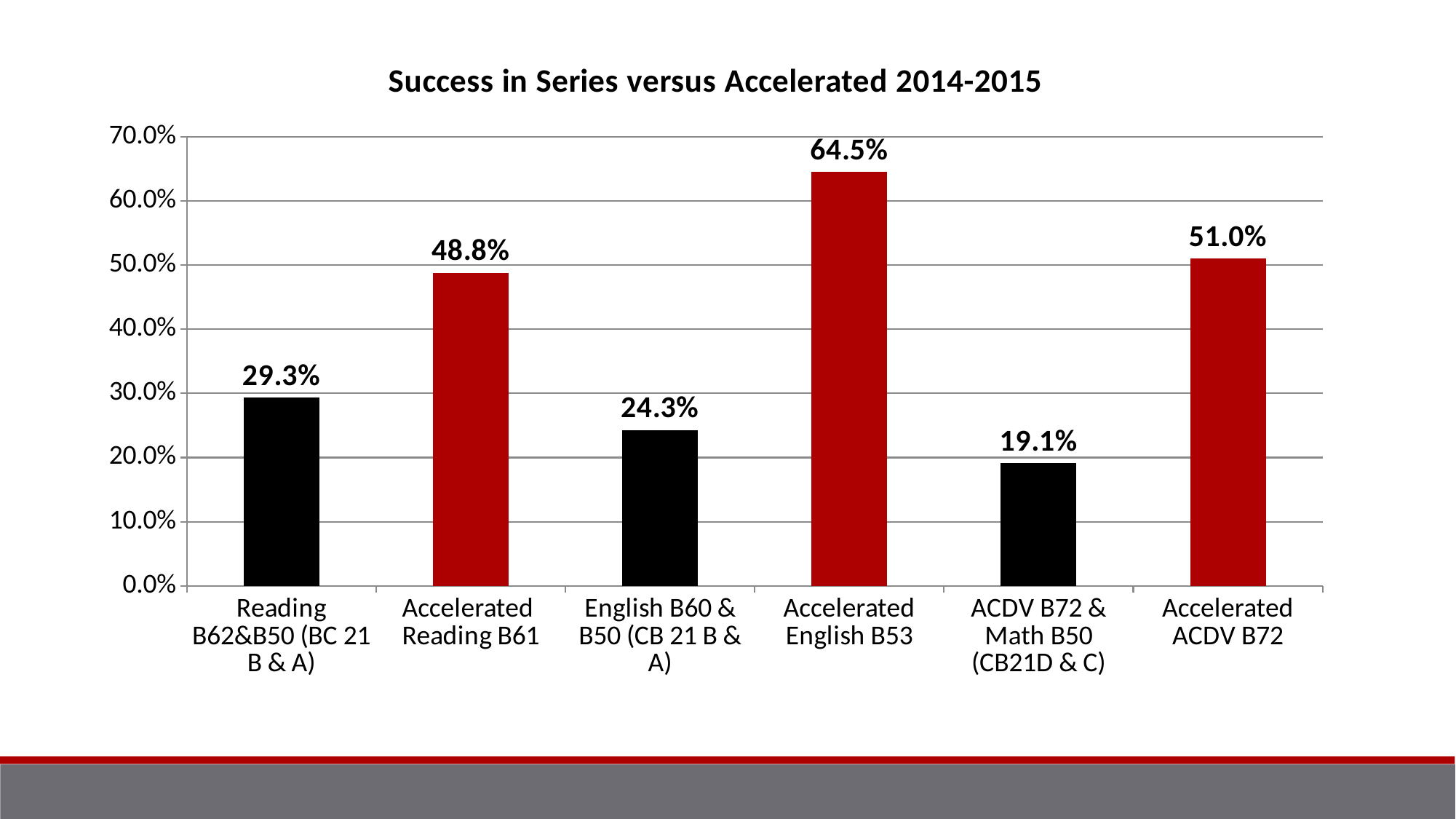
Which category has the highest value? Accelerated English B53 What is the difference between Accelerated Reading B61 and Reading B62&B50 (BC 21 B & A)? 19.5% How many categories are shown on the x axis? 6 Which category has the lowest value? ACDV B72 & Math B50 (CB21D & C) What is the value for Accelerated English B53? 64.5% What is the value for ACDV B72 & Math B50 (CB21D & C)? 19.1% What is the title of the chart? Success in Series versus Accelerated 2014-2015 What is the value for Accelerated Reading B61? 48.8% Which is larger, Accelerated ACDV B72 or Accelerated Reading B61? Accelerated ACDV B72 What kind of chart is this? Bar chart What is the difference between Accelerated English B53 and English B60 & B50 (CB 21 B & A)? 40.2% Is the value for Accelerated ACDV B72 greater or less than 50.0%? greater